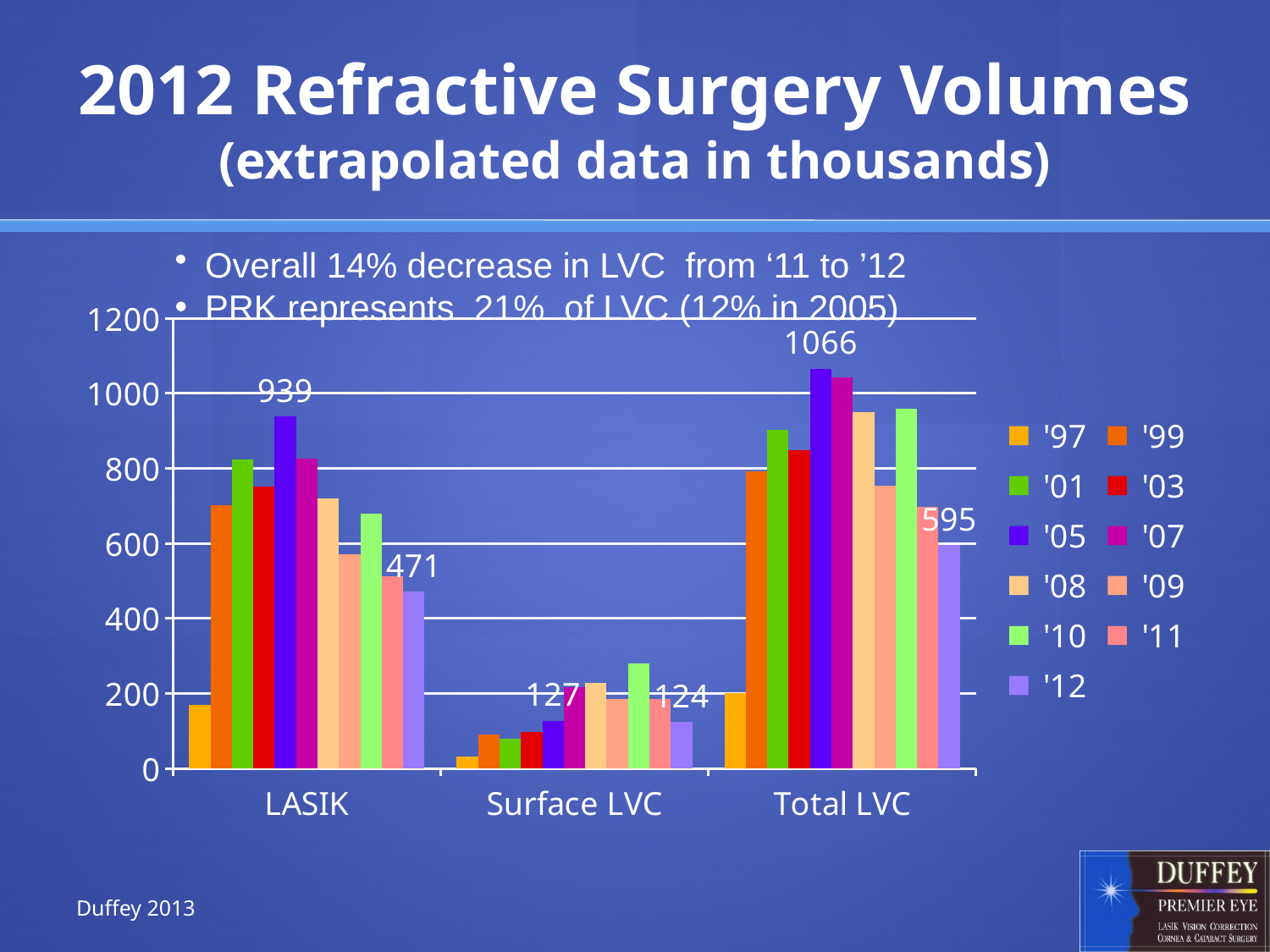
What is the Total LVC value for '05? 1066 What is the difference between the LASIK values for '05 and '12? 468 How many series does the chart's legend list? 11 What kind of chart is shown on the slide? bar chart What is the Surface LVC value for '12? 124 What is the LASIK value for '05? 939 How many categories are shown on the x axis of the chart? 3 Which category has the lowest values overall in the chart? Surface LVC What is the Total LVC value for '12? 595 What is the LASIK value for '12? 471 What is the difference between the Total LVC values for '05 and '12? 471 Is the LASIK value for '97 greater or less than 200? less